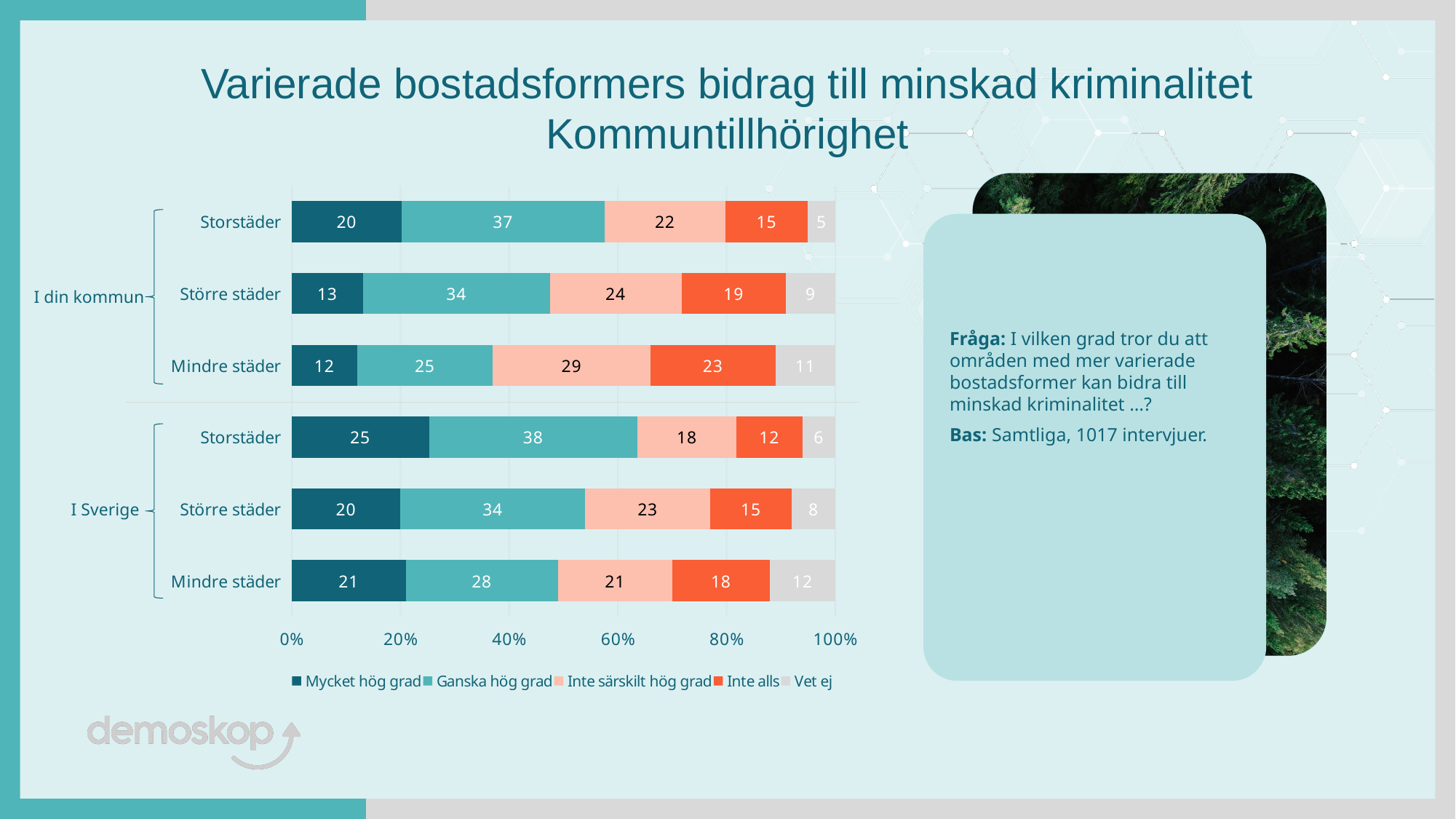
Which bar has the highest "Mycket hög grad" value? Storstäder (I Sverige) How many series does the legend list? 5 What kind of chart is shown on the slide? Stacked bar chart What is the difference between the "Inte alls" values for Mindre städer and Storstäder in the "I din kommun" group? 8 Which is larger: "Ganska hög grad" for Storstäder in "I din kommun" or "Ganska hög grad" for Storstäder in "I Sverige"? Storstäder in I Sverige How many bars are plotted in the chart? 6 What is the total of the stacked bar for Mindre städer in the "I Sverige" group? 100 What is the value of "Mycket hög grad" for Storstäder in the "I din kommun" group? 20 What is the value of "Vet ej" for Större städer in the "I din kommun" group? 9 What is the first entry in the chart legend? Mycket hög grad What is the value of "Inte alls" for Mindre städer in the "I Sverige" group? 18 Which bar has the lowest "Ganska hög grad" value? Mindre städer (I din kommun)